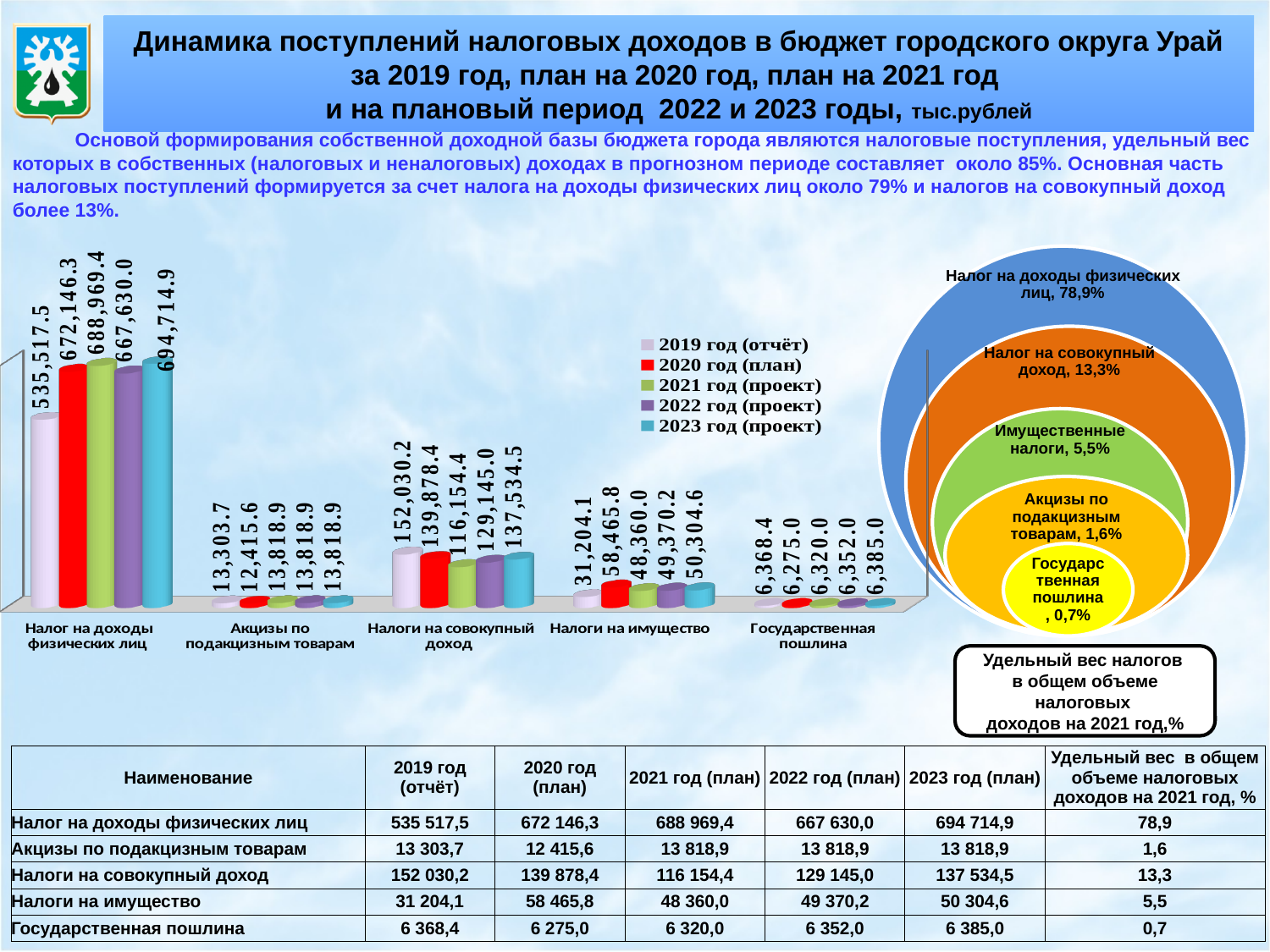
In the bar chart on the left, what is the difference between the 2020 год (план) and 2019 год (отчёт) values for Налог на доходы физических лиц? 136,628.8 In the bar chart on the left, what is the value for Налоги на совокупный доход in the 2019 год (отчёт) series? 152,030.2 In the bar chart on the left, which is larger for Налоги на имущество: the 2019 год (отчёт) value or the 2020 год (план) value? 2020 год (план) In the bar chart on the left, how many series does the legend list? 5 What kind of chart is the chart on the left of the slide? bar chart In the bar chart on the left, which category has the highest value in the 2021 год (проект) series? Налог на доходы физических лиц In the bar chart on the left, how many categories are shown on the x axis? 5 In the nested circle diagram on the right, what share is shown for Налог на совокупный доход? 13,3% In the bar chart on the left, what is the value for Налог на доходы физических лиц in the 2023 год (проект) series? 694,714.9 In the bar chart on the left, what is the first entry in the legend? 2019 год (отчёт) In the bar chart on the left, which category has the lowest value in the 2020 год (план) series? Государственная пошлина In the bar chart on the left, do the values for Налоги на совокупный доход rise or fall from 2019 год (отчёт) to 2021 год (проект)? fall